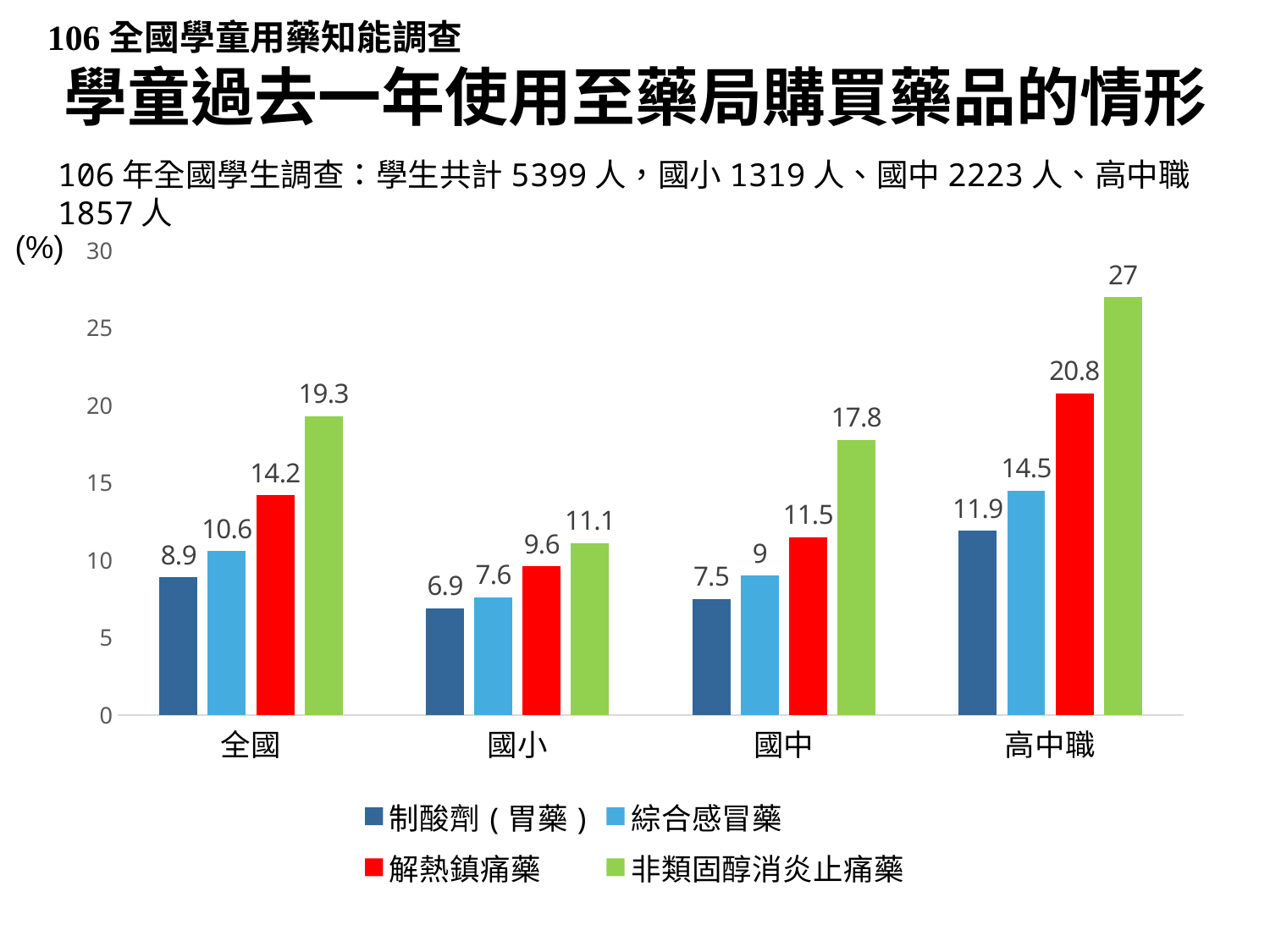
What is the value for 非類固醇消炎止痛藥 in the 高中職 group? 27 What is the difference between the 非類固醇消炎止痛藥 values for 高中職 and 國小? 15.9 Which group has the highest value for 非類固醇消炎止痛藥? 高中職 Which group has the lowest value for 制酸劑（胃藥）? 國小 How many series does the legend list? 4 Which colour represents 解熱鎮痛藥 in the legend? Red Which is larger: 解熱鎮痛藥 for 全國 or 綜合感冒藥 for 高中職? 綜合感冒藥 for 高中職 What is the value for 制酸劑（胃藥） in the 全國 group? 8.9 What is the value for 綜合感冒藥 in the 國小 group? 7.6 What is the value for 解熱鎮痛藥 in the 國中 group? 11.5 What kind of chart is shown on the slide? Bar chart How many groups are shown on the x axis? 4